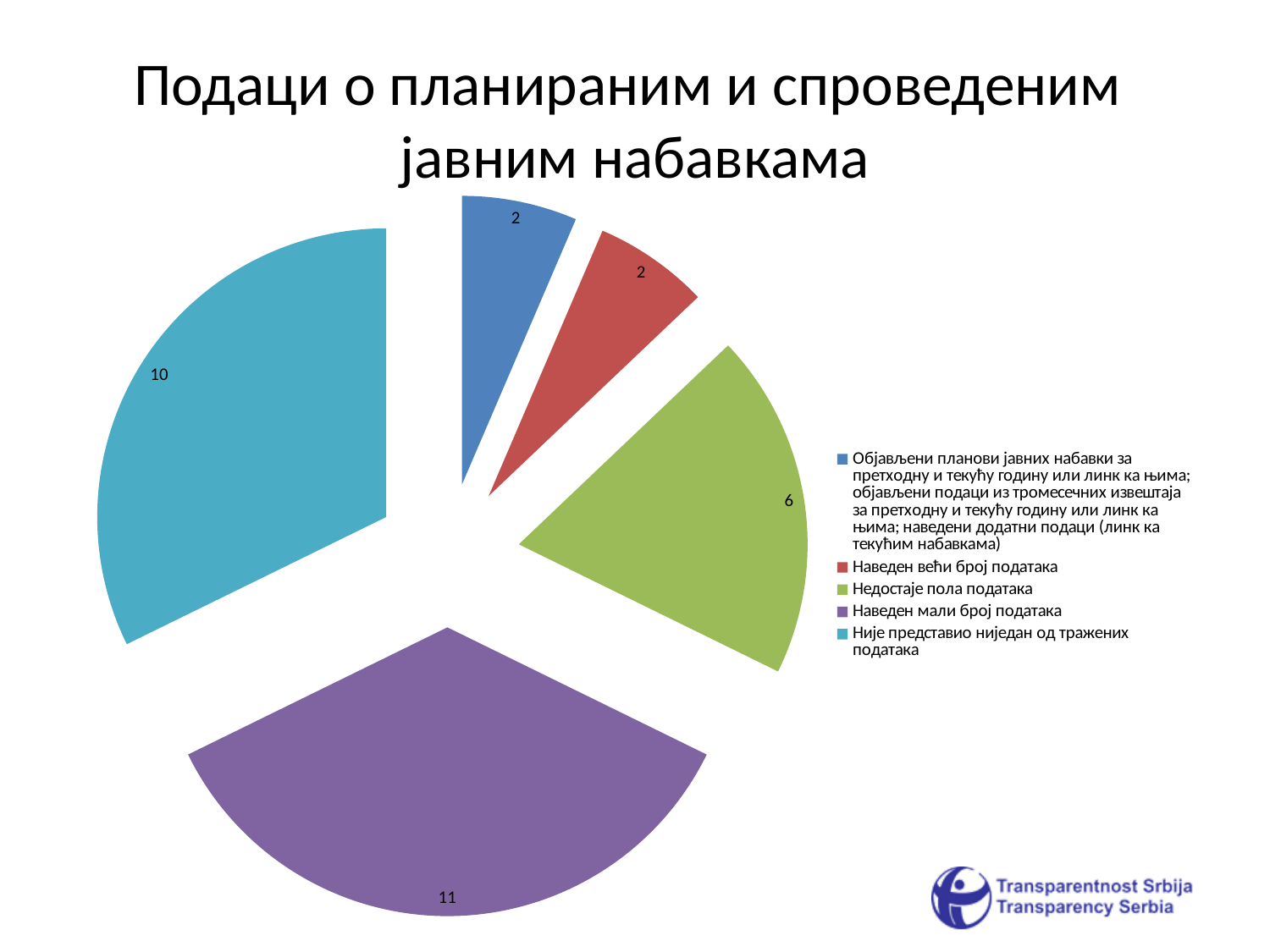
What is the value for "Није представио ниједан од тражених података"? 10 How many slices does the pie chart have? 5 What is the value for "Недостаје пола података"? 6 What is the value for "Наведен мали број података"? 11 What is the title of the chart on the slide? Подаци о планираним и спроведеним јавним набавкама Which category has the largest slice? Наведен мали број података Which is larger: the value for "Наведен мали број података" or the value for "Није представио ниједан од тражених података"? Наведен мали број података What is the value for "Наведен већи број података"? 2 What is the difference between the values for "Наведен мали број података" and "Недостаје пола података"? 5 What is the total of all slice values in the pie chart? 31 What colour is the slice for "Недостаје пола података"? green What kind of chart is shown on the slide? pie chart